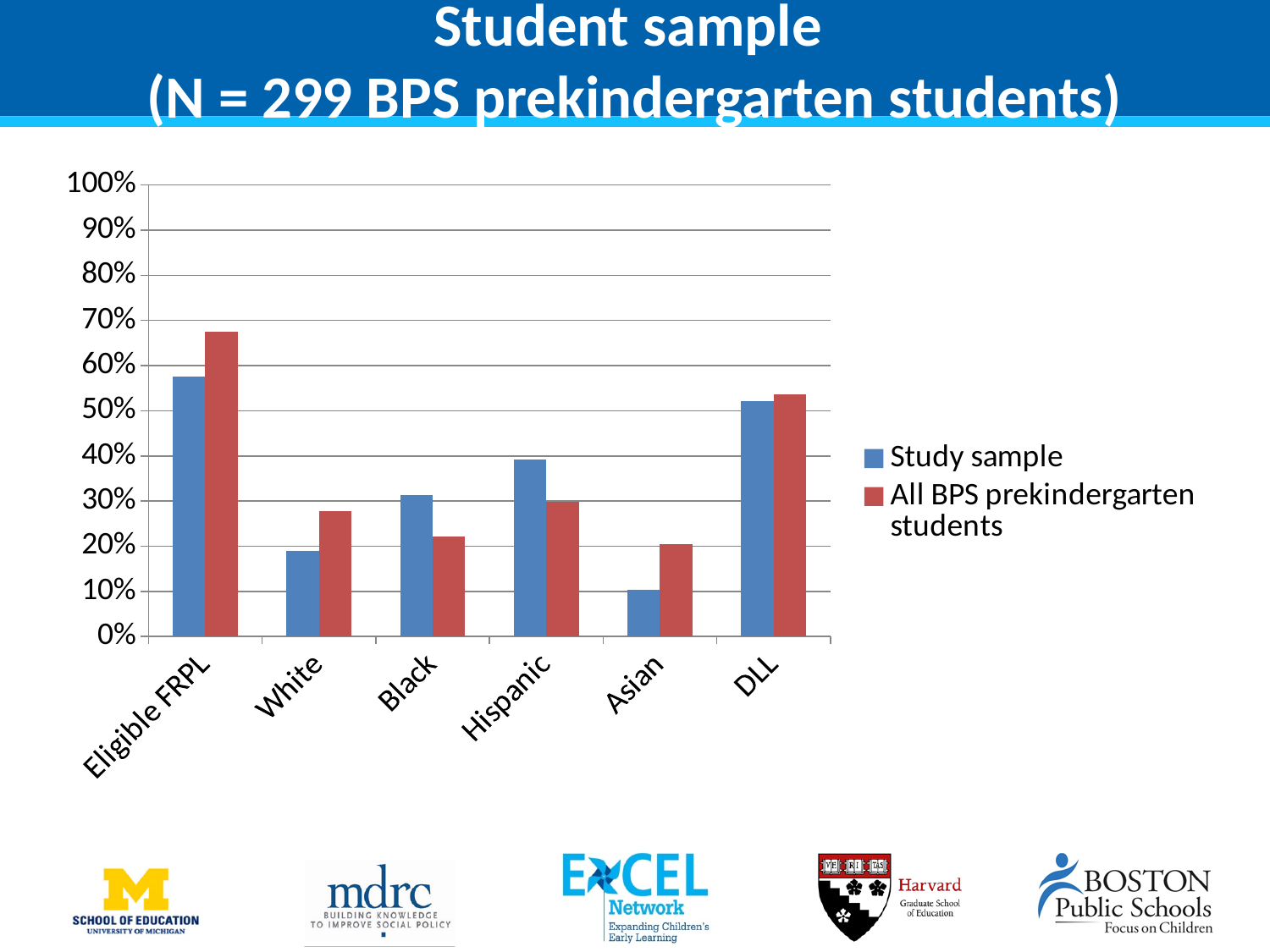
Is the value for Asian in the Study sample series greater or less than 20%? less Is the value for Eligible FRPL in the All BPS prekindergarten students series greater or less than 60%? greater For Hispanic, which series has the larger value: Study sample or All BPS prekindergarten students? Study sample Is the value for DLL in the Study sample series greater or less than 40%? greater For Black, which series has the larger value: Study sample or All BPS prekindergarten students? Study sample How many series does the legend list? 2 Which category has the highest value for the All BPS prekindergarten students series? Eligible FRPL What colour are the bars for the All BPS prekindergarten students series? red What kind of chart is shown on the slide? bar chart How many categories are shown on the x axis? 6 Which category has the highest value for the Study sample series? Eligible FRPL Which category has the lowest value for the Study sample series? Asian